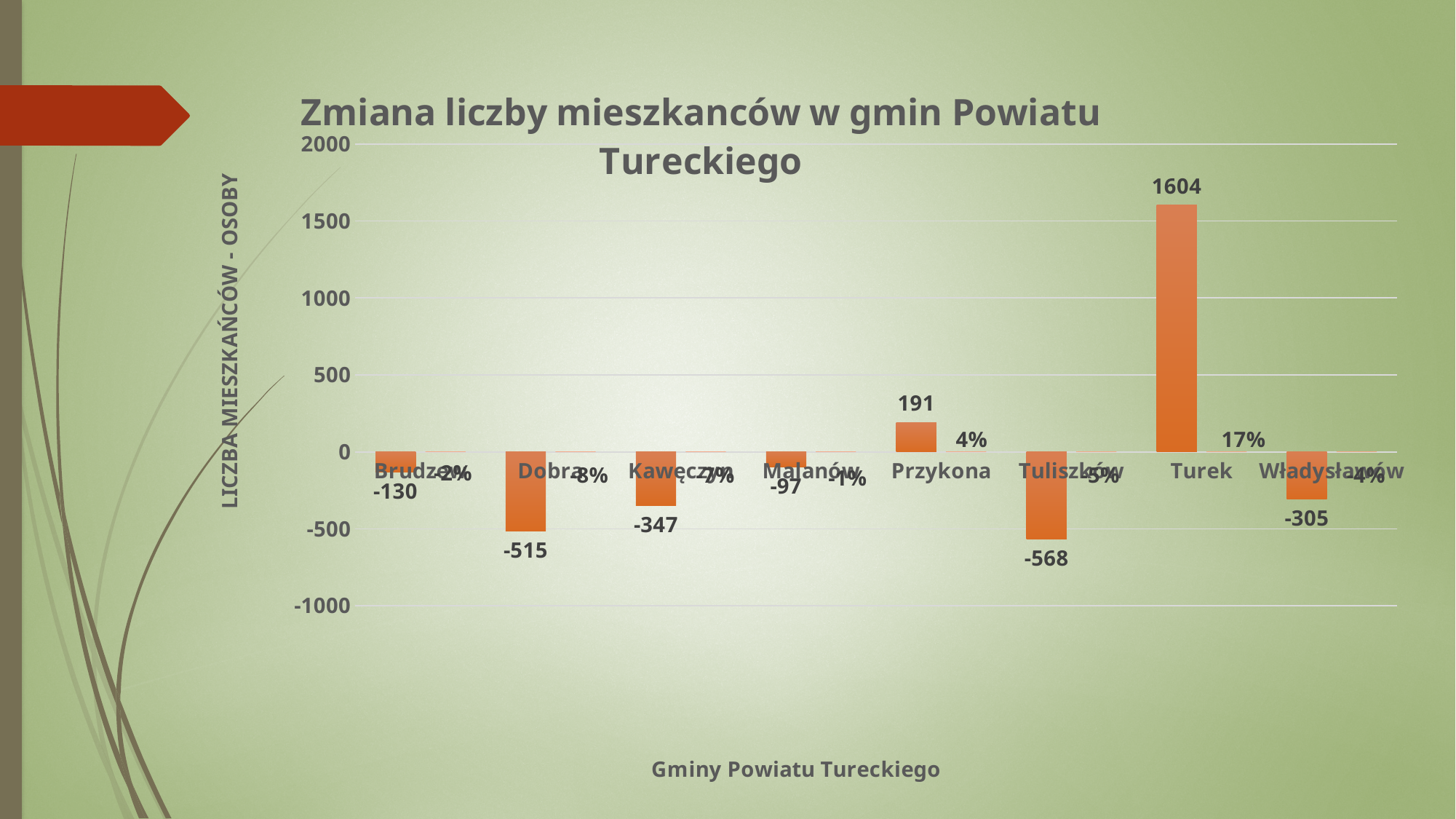
What is the x-axis title of the chart? Gminy Powiatu Tureckiego What is the difference between the values for Turek and Przykona? 1413 Which gmina has the lowest value? Tuliszków What is the value for Tuliszków? -568 Which gmina has the highest value? Turek Which value is larger, Dobra or Kawęczyn? Kawęczyn What kind of chart is this? bar chart What is the value for Władysławów? -305 What is the value for Turek? 1604 How many gminy are shown on the x axis? 8 What is the value for Przykona? 191 What is the value for Brudzew? -130